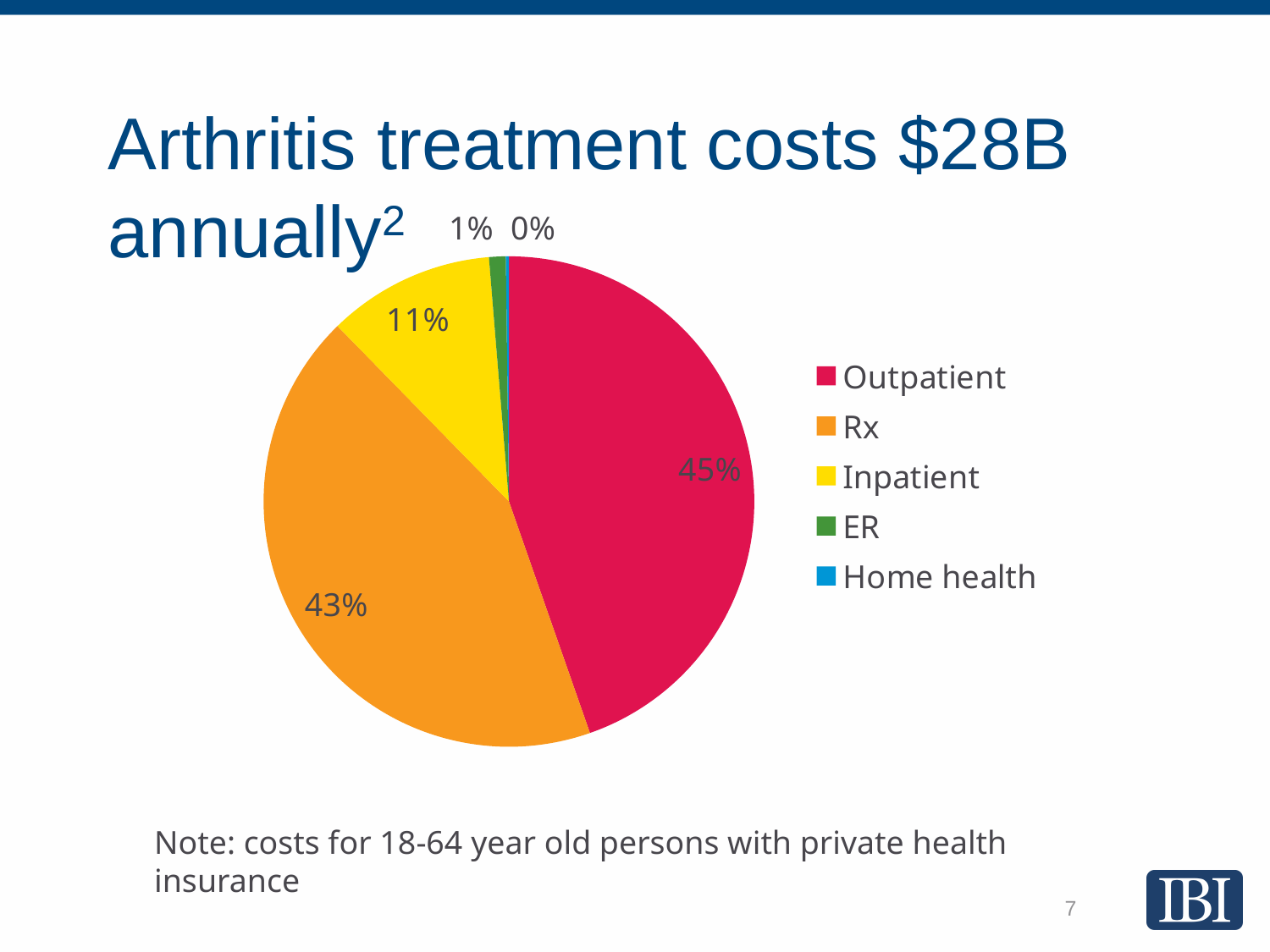
Which category has the smallest share of arthritis treatment costs? Home health What colour represents Rx in the pie chart? Orange What share of arthritis treatment costs is Outpatient? 45% What kind of chart is shown on the slide? Pie chart Which is larger, the Rx share or the Inpatient share? Rx What share of arthritis treatment costs is Rx? 43% What is the difference in percentage points between the Outpatient and Inpatient shares? 34 What share of arthritis treatment costs is Home health? 0% What share of arthritis treatment costs is Inpatient? 11% What share of arthritis treatment costs is ER? 1% Which category has the largest share of arthritis treatment costs? Outpatient How many categories does the pie chart show? 5